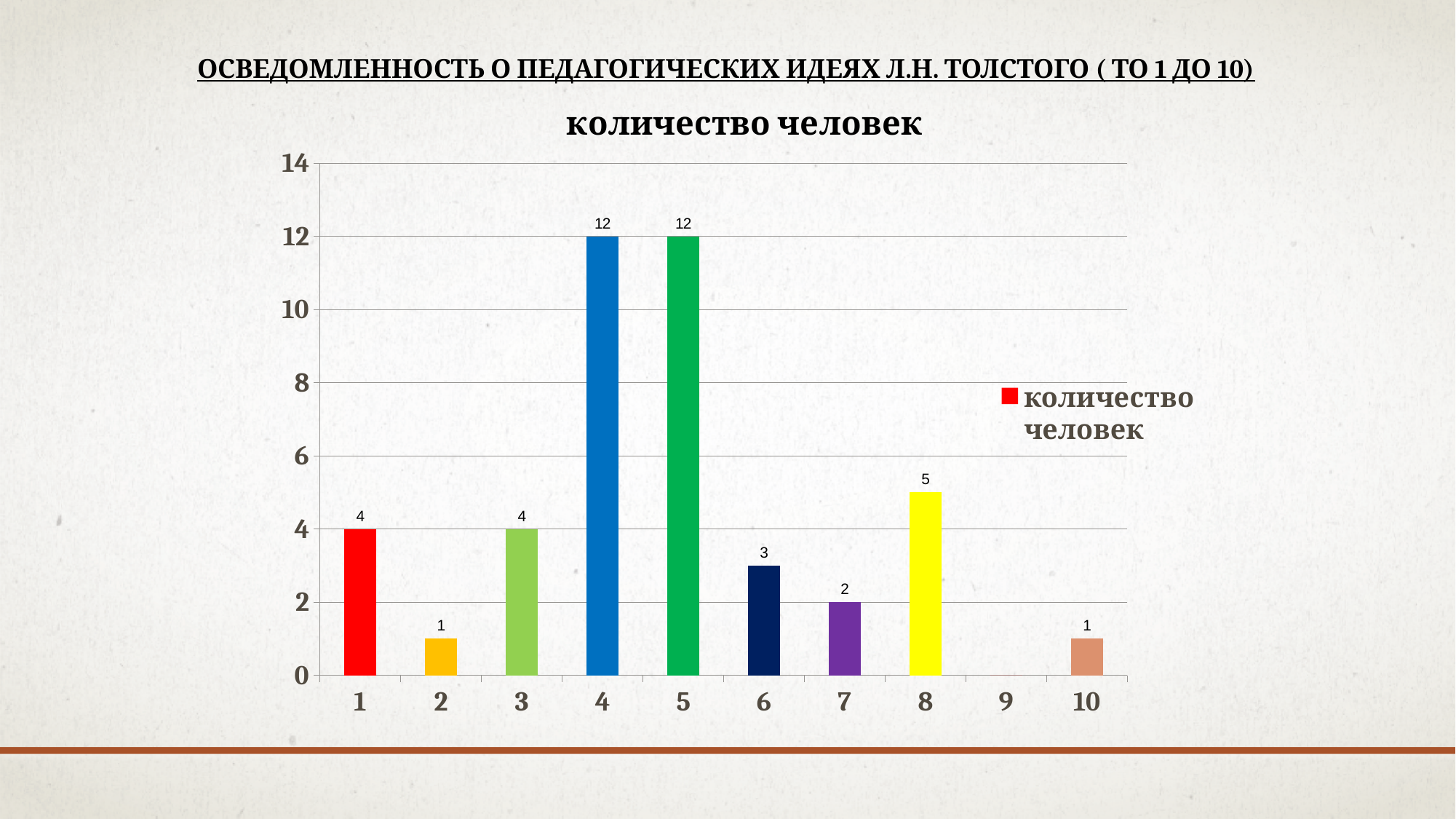
What is the difference between the values for category 5 and category 8? 7 What is the value for category 10? 1 What is the highest value shown in the chart? 12 What is the value for category 8? 5 How many categories are shown on the x axis? 10 Which has a larger value, category 3 or category 6? category 3 What type of chart is shown on the slide? bar chart What is the value for category 6? 3 What is the legend entry of the chart? количество человек What is the value for category 4? 12 What is the difference between the values for category 1 and category 7? 2 Is the value for category 4 greater or less than 10? greater